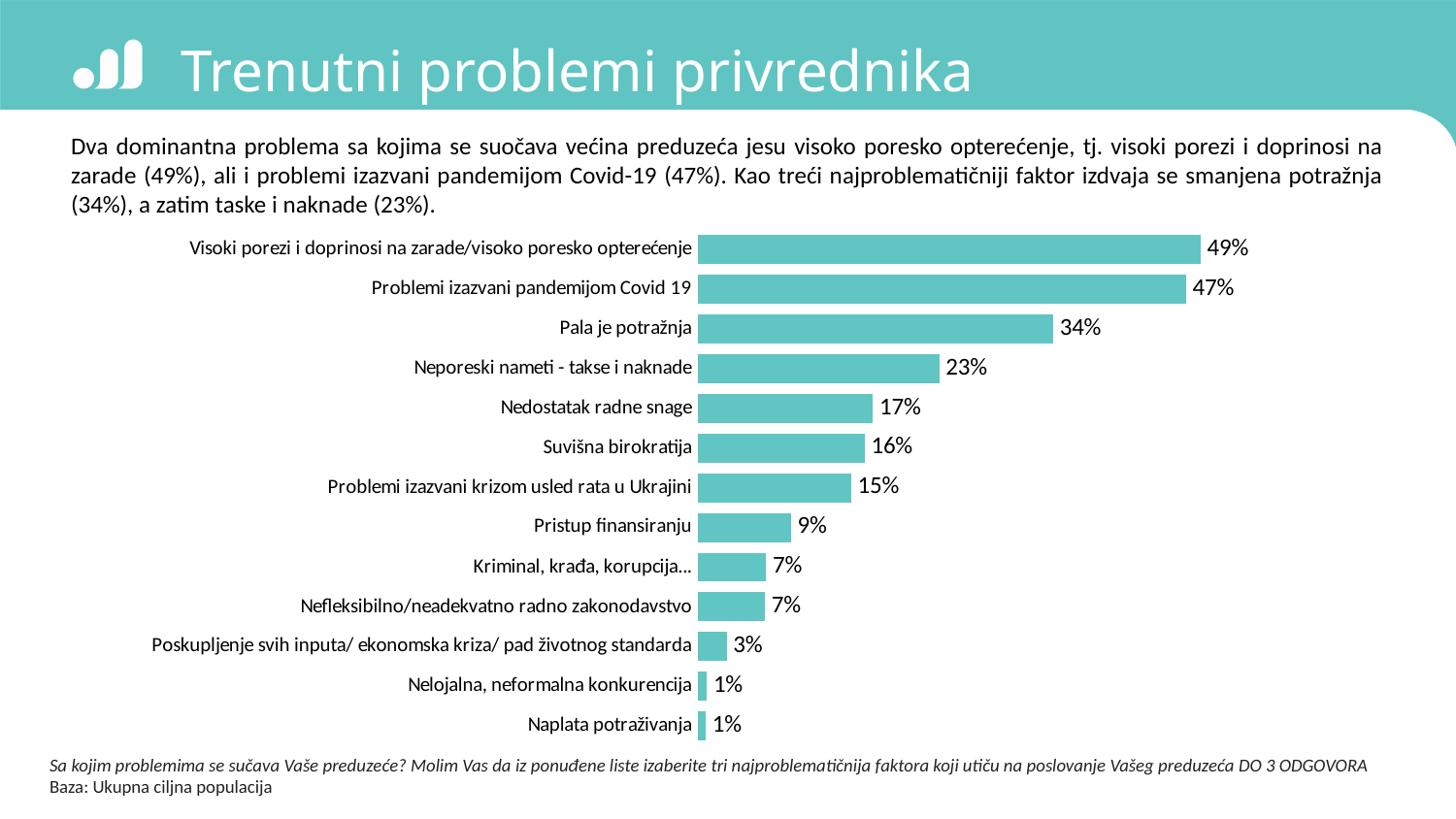
What is the value for "Pristup finansiranju"? 9% What kind of chart is shown on the slide? Bar chart What is the difference between "Visoki porezi i doprinosi na zarade/visoko poresko opterećenje" and "Problemi izazvani pandemijom Covid 19"? 2% What is the value for "Problemi izazvani krizom usled rata u Ukrajini"? 15% Which category has the highest value? Visoki porezi i doprinosi na zarade/visoko poresko opterećenje What is the value for "Poskupljenje svih inputa/ ekonomska kriza/ pad životnog standarda"? 3% Which is larger, "Suvišna birokratija" or "Neporeski nameti - takse i naknade"? Neporeski nameti - takse i naknade What is the difference between "Pala je potražnja" and "Neporeski nameti - takse i naknade"? 11% What is the value for "Nedostatak radne snage"? 17% What is the title of the slide? Trenutni problemi privrednika What is the value for "Pala je potražnja"? 34% How many categories are shown in the chart? 13